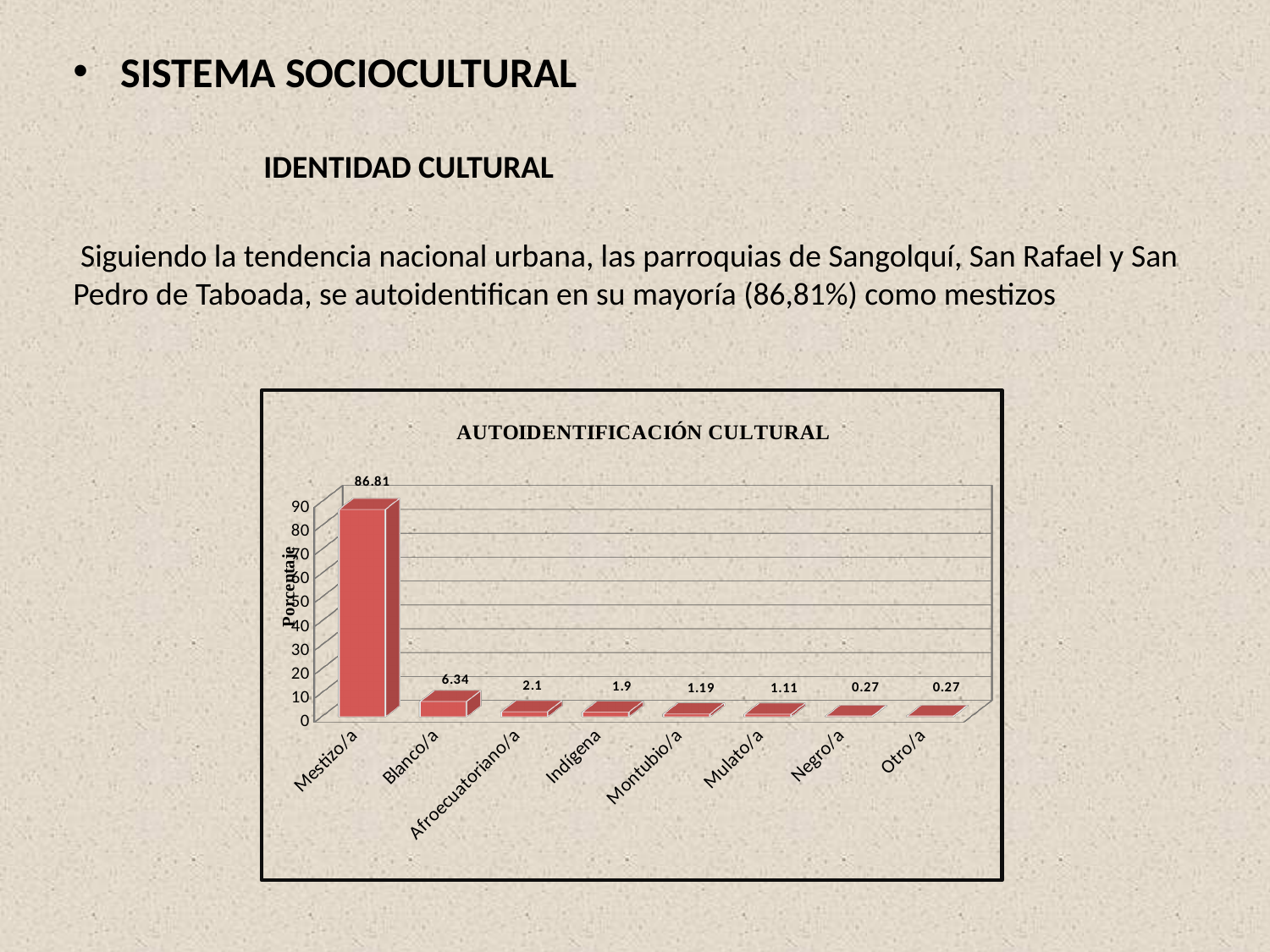
What is the value for Mestizo/a? 86.81 Which category has the highest value? Mestizo/a Which is larger, the value for Afroecuatoriano/a or the value for Indígena? Afroecuatoriano/a What is the value for Afroecuatoriano/a? 2.1 What is the title of the chart? AUTOIDENTIFICACIÓN CULTURAL What is the difference between the values for Indígena and Mulato/a? 0.79 What is the value for Blanco/a? 6.34 What is the value for Montubio/a? 1.19 How many categories are shown on the x axis? 8 Is the value for Mestizo/a greater or less than 80? greater What is the difference between the values for Mestizo/a and Blanco/a? 80.47 What kind of chart is this? bar chart